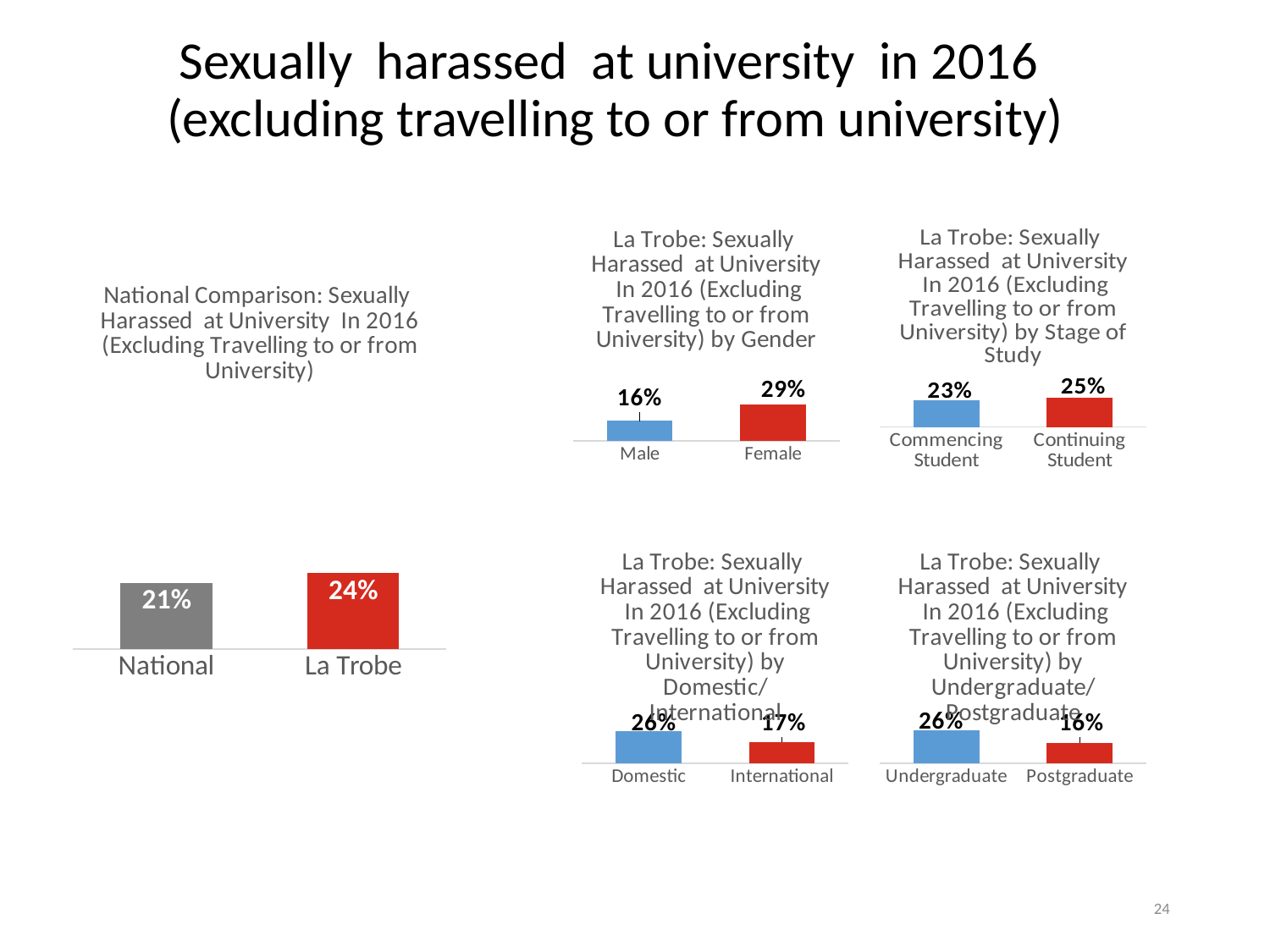
In the National Comparison chart, what is the value for National? 21% In the National Comparison chart, what is the value for La Trobe? 24% In the chart by Undergraduate/Postgraduate, what is the value for Undergraduate? 26% In the chart by Gender, what is the difference between the Female and Male values? 13% In the chart by Gender, what is the value for Female? 29% In the chart by Undergraduate/Postgraduate, what is the difference between the Undergraduate and Postgraduate values? 10% What type of chart is the National Comparison chart? Bar chart In the chart by Domestic/International, what is the value for International? 17% In the National Comparison chart, what is the difference between the La Trobe and National values? 3% In the chart by Stage of Study, which category has the higher value? Continuing Student In the chart by Domestic/International, which category has the lower value? International In the chart by Stage of Study, what is the value for Commencing Student? 23%